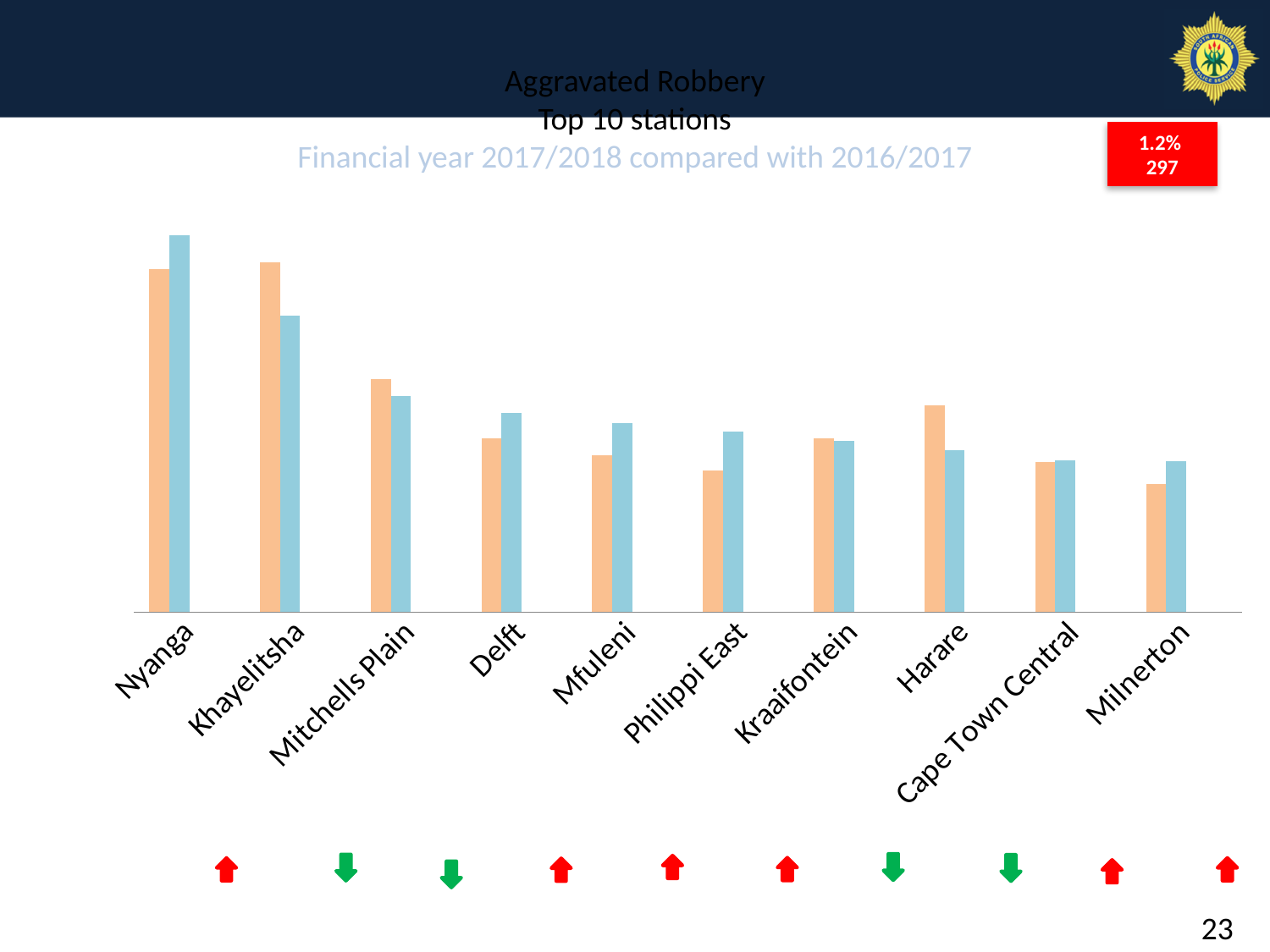
For Mitchells Plain, which bar is taller, the orange bar or the blue bar? orange bar Which two financial years does the chart subtitle say are being compared? 2017/2018 and 2016/2017 How many bars are plotted for each station in the chart? 2 Which station has the lowest orange bar in the chart? Milnerton Which crime type is named in the chart title? Aggravated Robbery How many stations are shown on the x axis of the chart? 10 For Khayelitsha, which bar is taller, the orange bar or the blue bar? orange bar For Harare, which bar is taller, the orange bar or the blue bar? orange bar What kind of chart is shown on the slide? bar chart Which station has the tallest bar in the chart? Nyanga